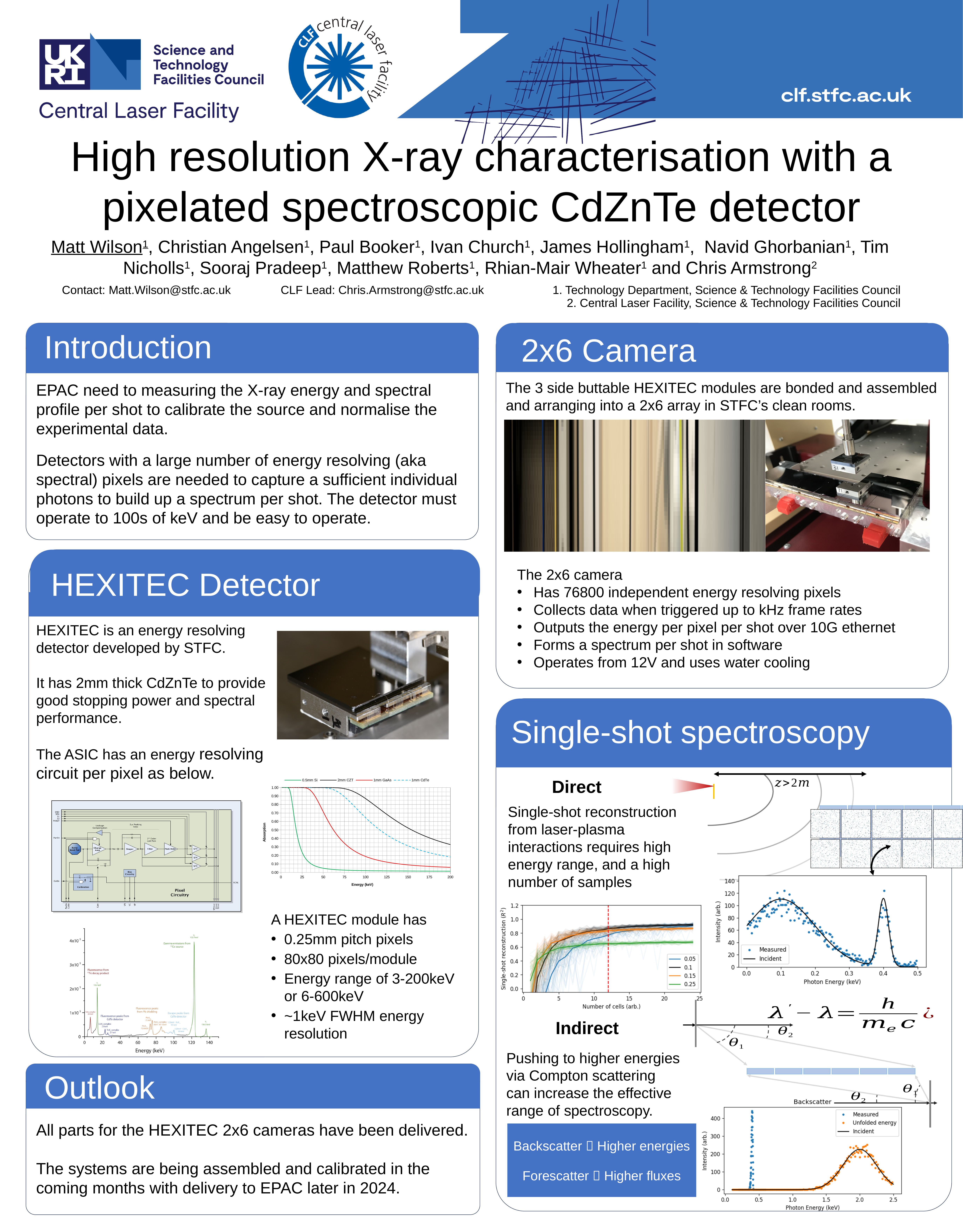
In the intensity versus photon energy chart at the bottom right under 'Indirect', how many series does the legend list? 3 In the absorption versus energy chart in the HEXITEC Detector section, is the absorption of 2mm CZT at 100 keV greater or less than 0.50? greater In the absorption versus energy chart in the HEXITEC Detector section, does absorption rise or fall as energy increases? fall In the intensity versus photon energy chart under 'Direct', what are the two legend entries? Measured, Incident In the single-shot reconstruction (R²) versus number of cells chart, how many series does the legend list? 4 In the absorption versus energy chart in the HEXITEC Detector section, what kind of chart is it? line chart In the absorption versus energy chart in the HEXITEC Detector section, which series has the highest absorption at 150 keV? 2mm CZT In the intensity versus photon energy chart at the bottom right under 'Indirect', is the peak of the Unfolded energy series near 2.0 keV greater or less than 300? less In the single-shot reconstruction (R²) versus number of cells chart, which legend series has the lowest R² at 20 cells? 0.25 In the absorption versus energy chart in the HEXITEC Detector section, which series has the lowest absorption at 100 keV? 0.5mm Si In the single-shot reconstruction (R²) versus number of cells chart, does R² rise or fall as the number of cells increases? rise In the absorption versus energy chart in the HEXITEC Detector section, how many series does the legend list? 4